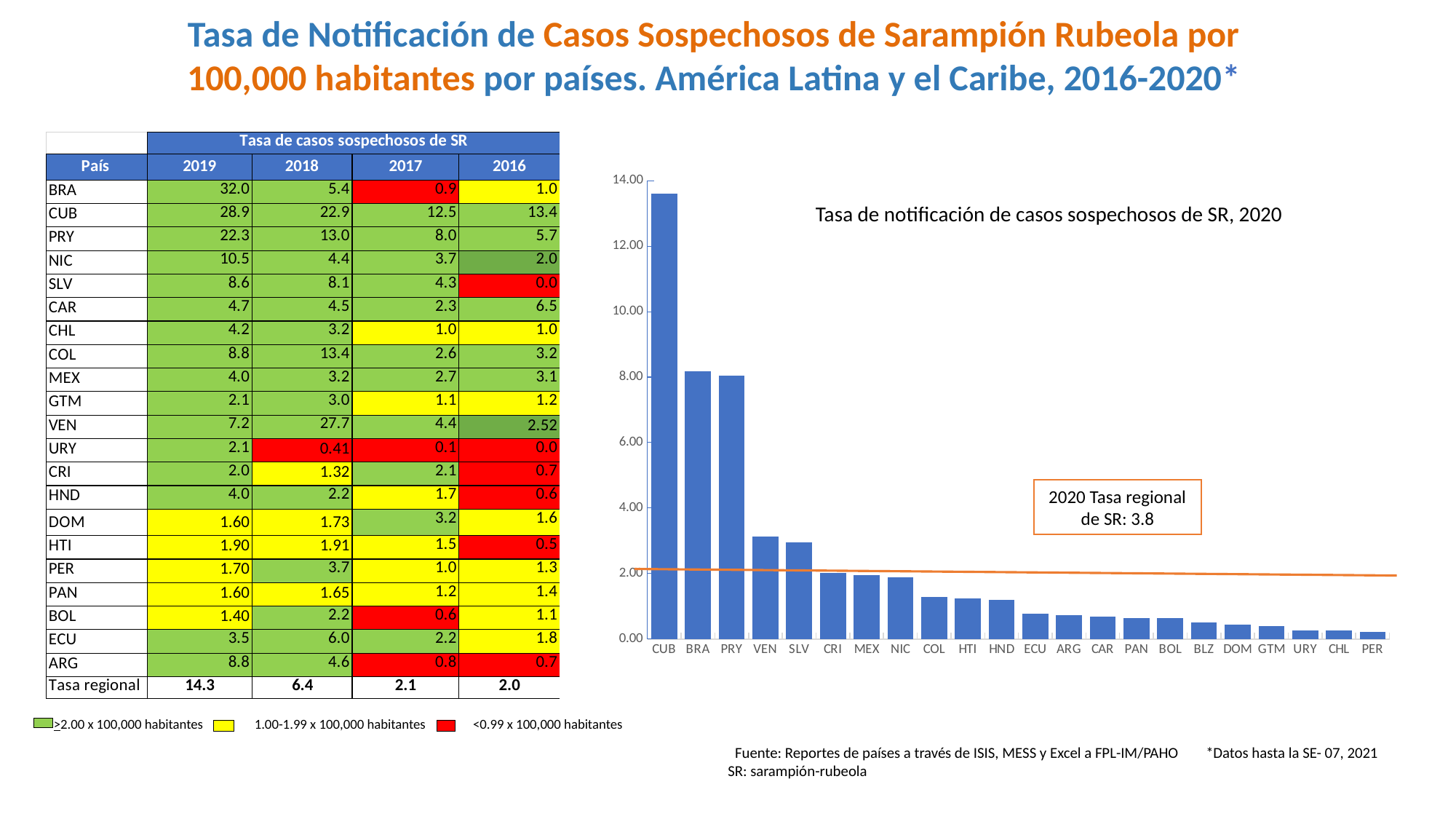
In the bar chart, which is larger, the value for VEN or the value for COL? VEN How many countries are shown on the x axis of the bar chart? 22 In the bar chart, is the value for COL greater or less than 2.00? less In the bar chart, which is larger, the value for CUB or the value for BRA? CUB In the bar chart, is the value for VEN greater or less than 2.00? greater In the bar chart, is the value for BRA greater or less than 6.00? greater In the bar chart, which country has the highest value? CUB What kind of chart is shown on the right side of the slide? bar chart What is the title of the bar chart? Tasa de notificación de casos sospechosos de SR, 2020 Do the bar values rise or fall from left to right along the x axis of the bar chart? fall